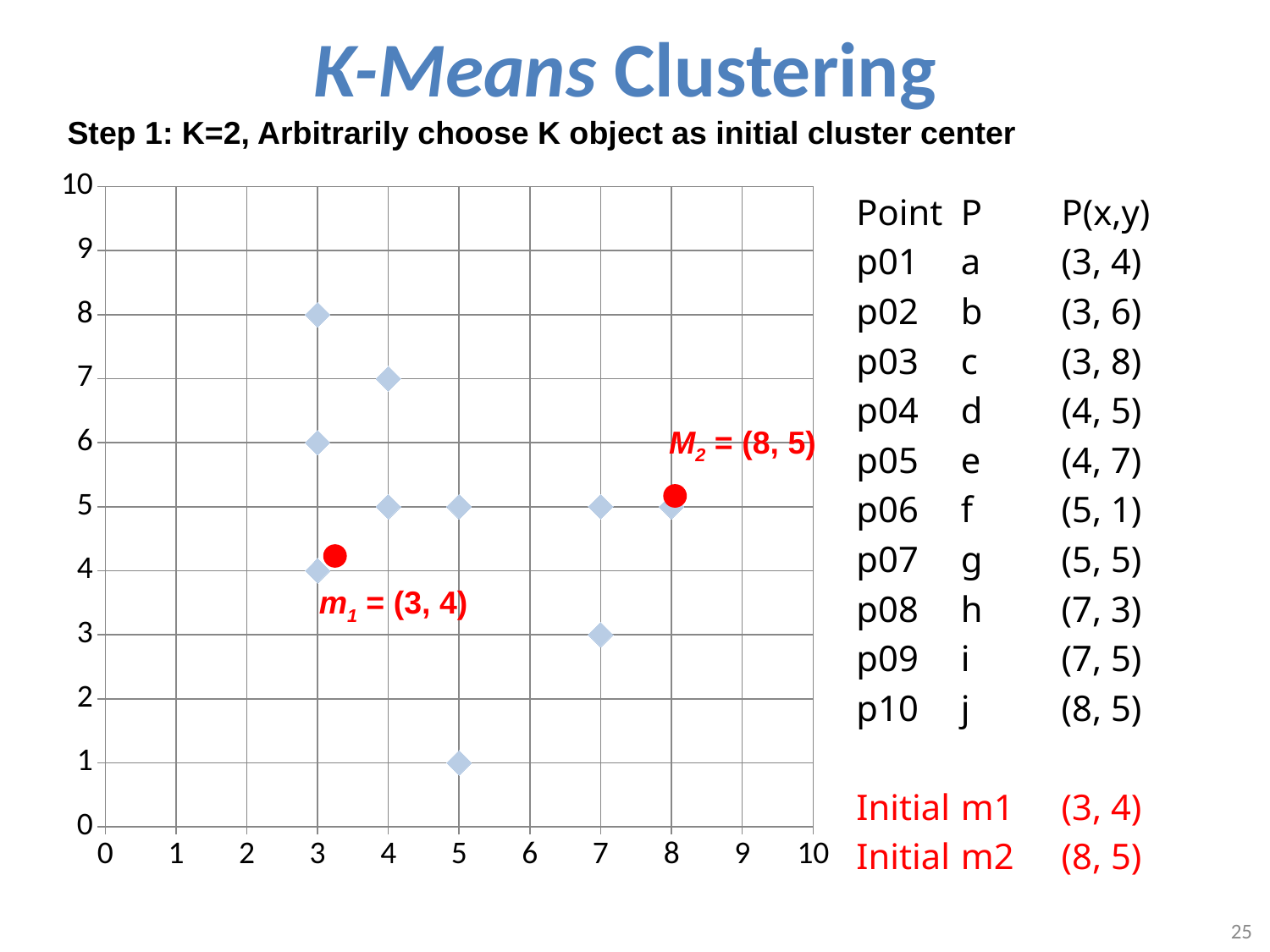
What is the difference in y value between point c (3, 8) and point a (3, 4)? 4 Which point has the lowest y value? f (5, 1) What are the coordinates of point c (p03)? (3, 8) What is the maximum value shown on the y axis? 10 How many points have an x value of 3? 3 How many blue data points are plotted on the chart? 10 What are the coordinates of the initial cluster center M2? (8, 5) Which point has the highest y value? c (3, 8) What kind of chart is shown on the slide? scatter chart Which point has the larger x value, h (7, 3) or d (4, 5)? h Is the x value of point j greater or less than 5? greater What are the coordinates of the initial cluster center m1? (3, 4)